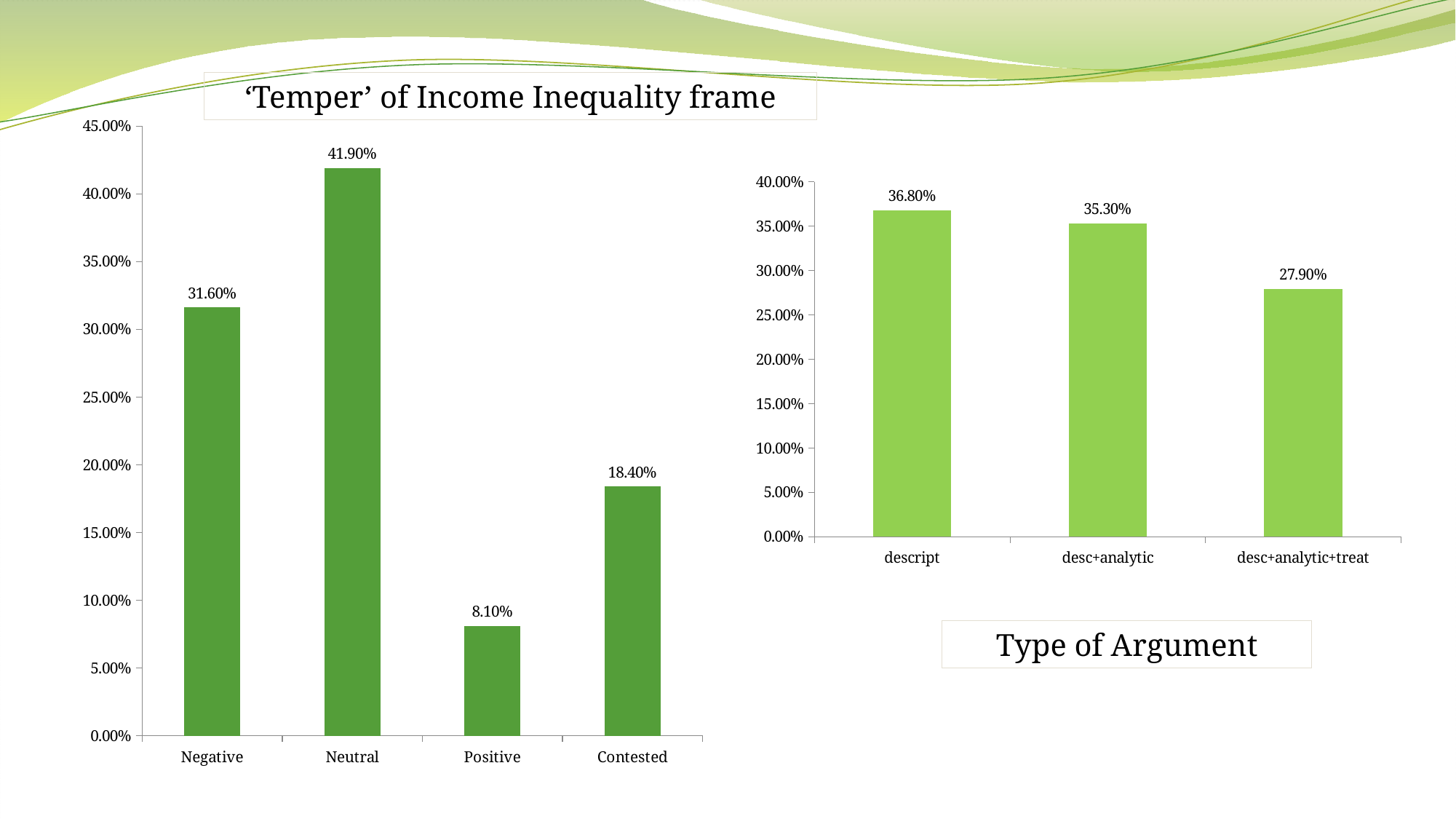
In the 'Temper' of Income Inequality frame chart, how many categories are shown? 4 In the Type of Argument chart, what is the difference between the descript and desc+analytic+treat values? 8.90% In the 'Temper' of Income Inequality frame chart, which category has the lowest value? Positive In the Type of Argument chart, do the values rise or fall from left to right across the categories? fall In the Type of Argument chart, what is the value for desc+analytic? 35.30% In the 'Temper' of Income Inequality frame chart, what is the value for Neutral? 41.90% In the 'Temper' of Income Inequality frame chart, what is the value for Contested? 18.40% In the Type of Argument chart, which category has the highest value? descript In the 'Temper' of Income Inequality frame chart, which category has the highest value? Neutral In the 'Temper' of Income Inequality frame chart, what is the difference between the Neutral and Negative values? 10.30% What kind of chart is the Type of Argument chart? bar chart In the Type of Argument chart, what is the value for desc+analytic+treat? 27.90%